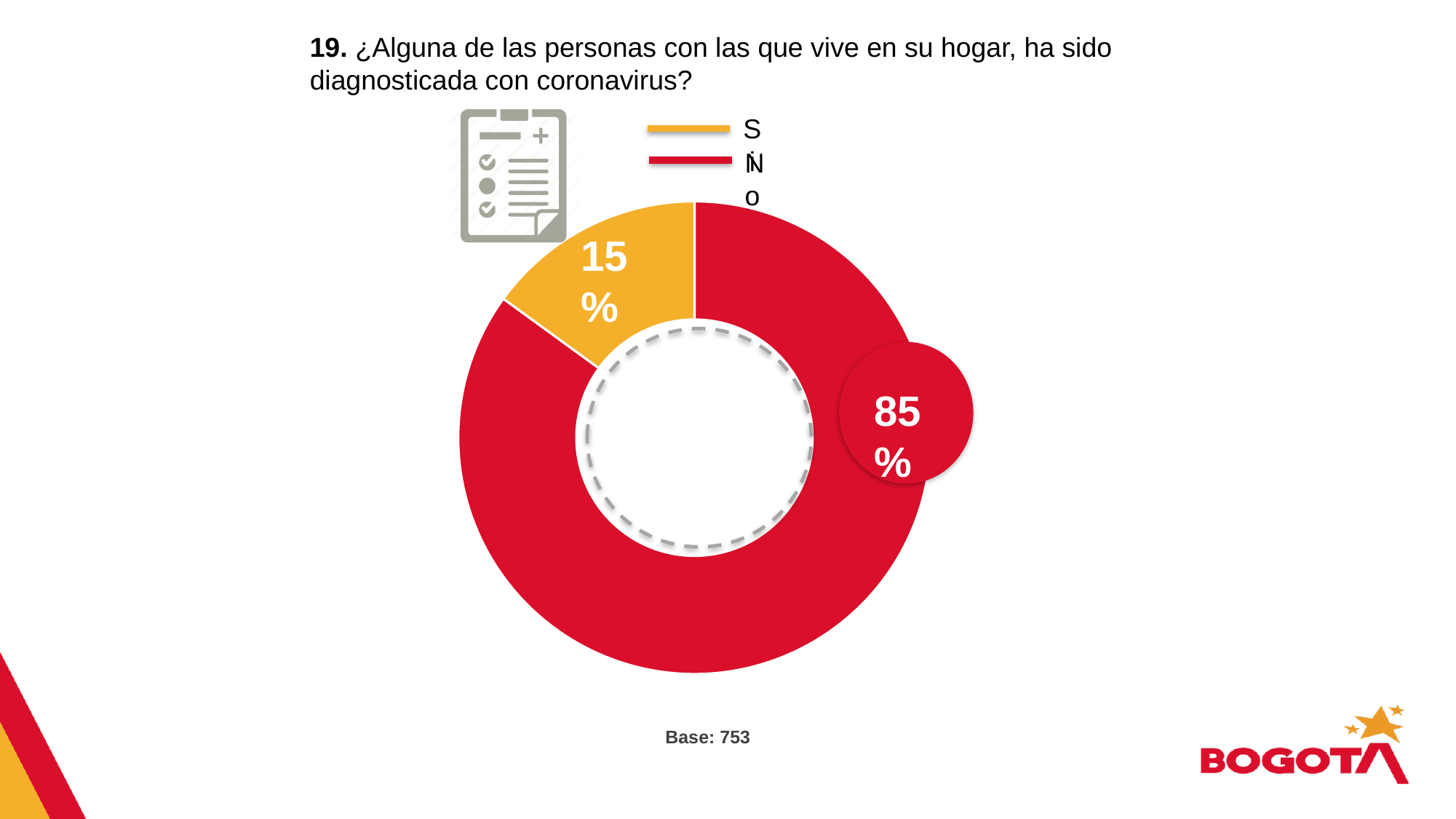
What kind of chart is shown on the slide? Doughnut (pie) chart Which is larger, the share for "Sí" or the share for "No"? No What percentage of respondents answered "No"? 85% What percentage of respondents answered "Sí"? 15% How many categories are shown in the chart? 2 Which response has the largest share of the chart? No How many entries does the legend list? 2 Which response has the smallest share of the chart? Sí What is the base (number of respondents) stated below the chart? 753 What colour represents the "No" response in the chart? Red What is the difference in percentage points between the "No" and "Sí" responses? 70 What is the total of the two percentages shown in the chart? 100%